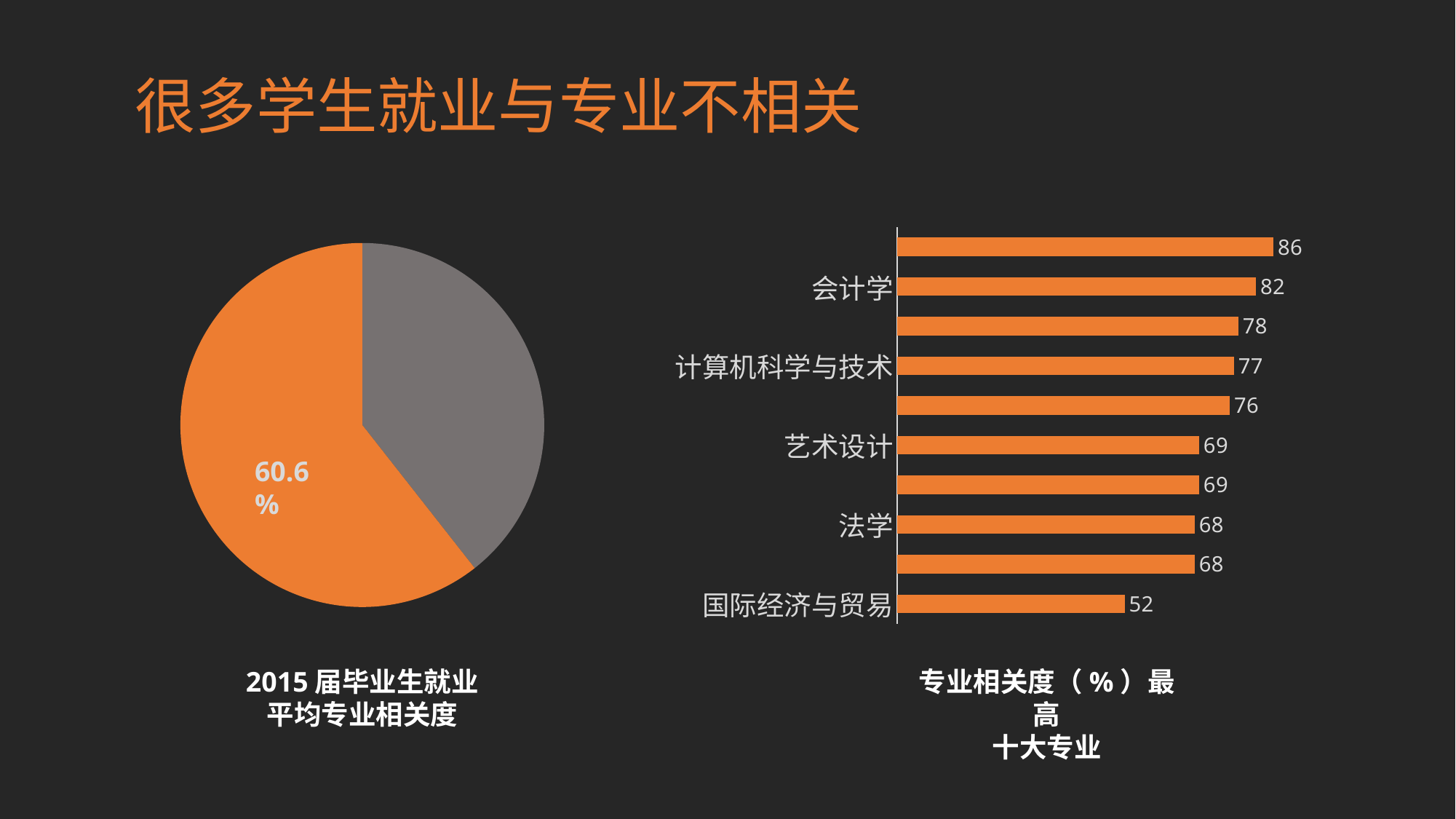
In the bar chart on the right, which labelled category has the lowest value? 国际经济与贸易 What kind of chart is shown on the right side of the slide? Bar chart In the bar chart on the right, what is the difference between the values for 会计学 and 法学? 14 In the bar chart on the right, what is the value for 法学? 68 What is the title of the chart on the left? 2015届毕业生就业平均专业相关度 In the bar chart on the right, which is larger, the value for 艺术设计 or the value for 国际经济与贸易? 艺术设计 In the bar chart on the right, what is the highest value shown on any bar? 86 In the bar chart on the right, what is the value for 计算机科学与技术? 77 In the bar chart on the right, what is the value for 会计学? 82 In the pie chart on the left, what share does the orange slice represent? 60.6% In the bar chart on the right, what is the value for 国际经济与贸易? 52 How many bars are plotted in the bar chart on the right? 10